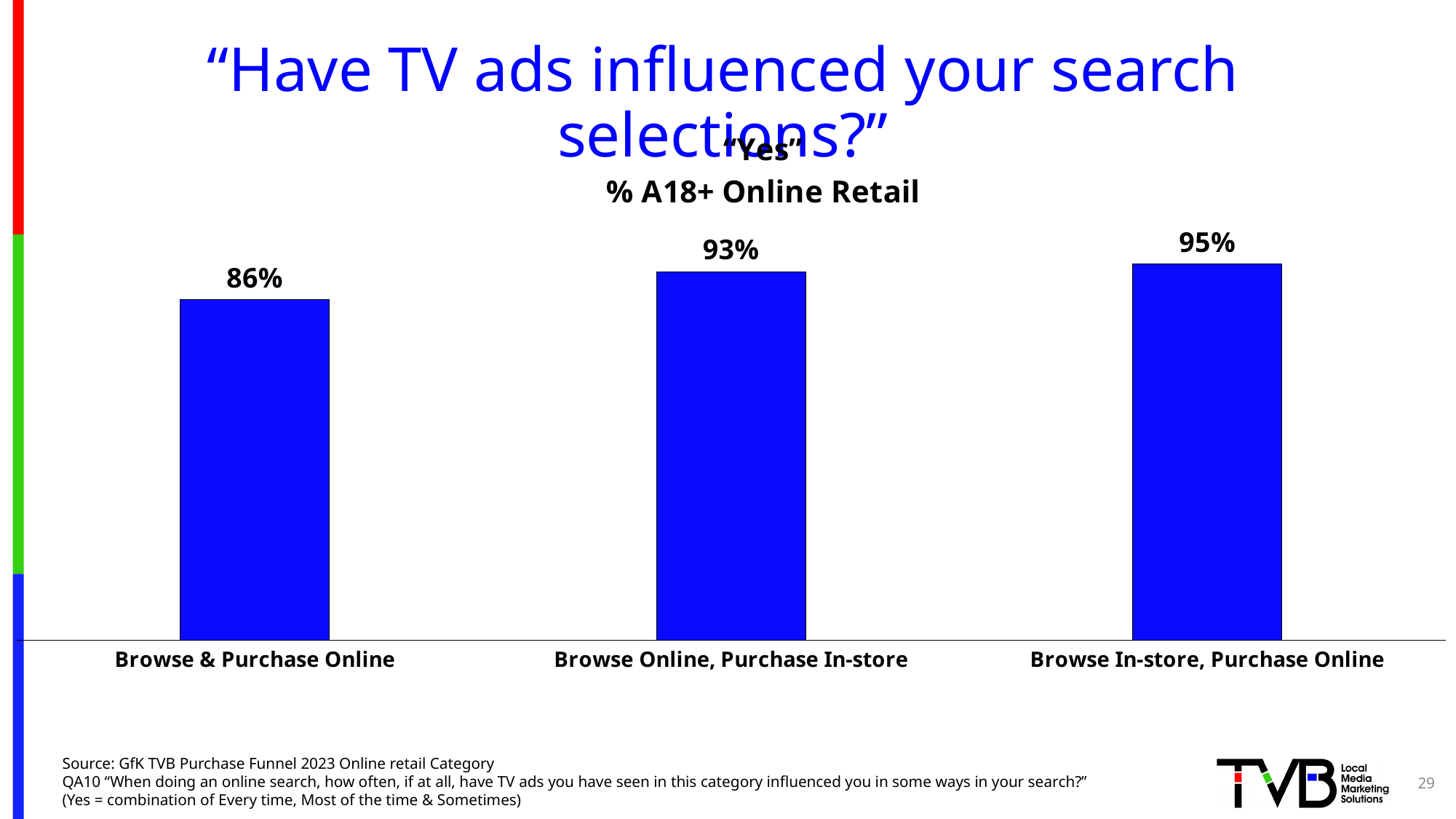
What is the value for Browse Online, Purchase In-store? 93% Do the values rise or fall from left to right across the categories? Rise What is the value for Browse In-store, Purchase Online? 95% Which category has the lowest value? Browse & Purchase Online Which is larger, the value for Browse Online, Purchase In-store or the value for Browse & Purchase Online? Browse Online, Purchase In-store Which category has the highest value? Browse In-store, Purchase Online How many categories are shown in the chart? 3 What is the difference between the values for Browse In-store, Purchase Online and Browse & Purchase Online? 9% What is the difference between the values for Browse Online, Purchase In-store and Browse & Purchase Online? 7% What kind of chart is shown on the slide? Bar chart What is the value for Browse & Purchase Online? 86% What is the subtitle shown above the chart describing the measure? % A18+ Online Retail